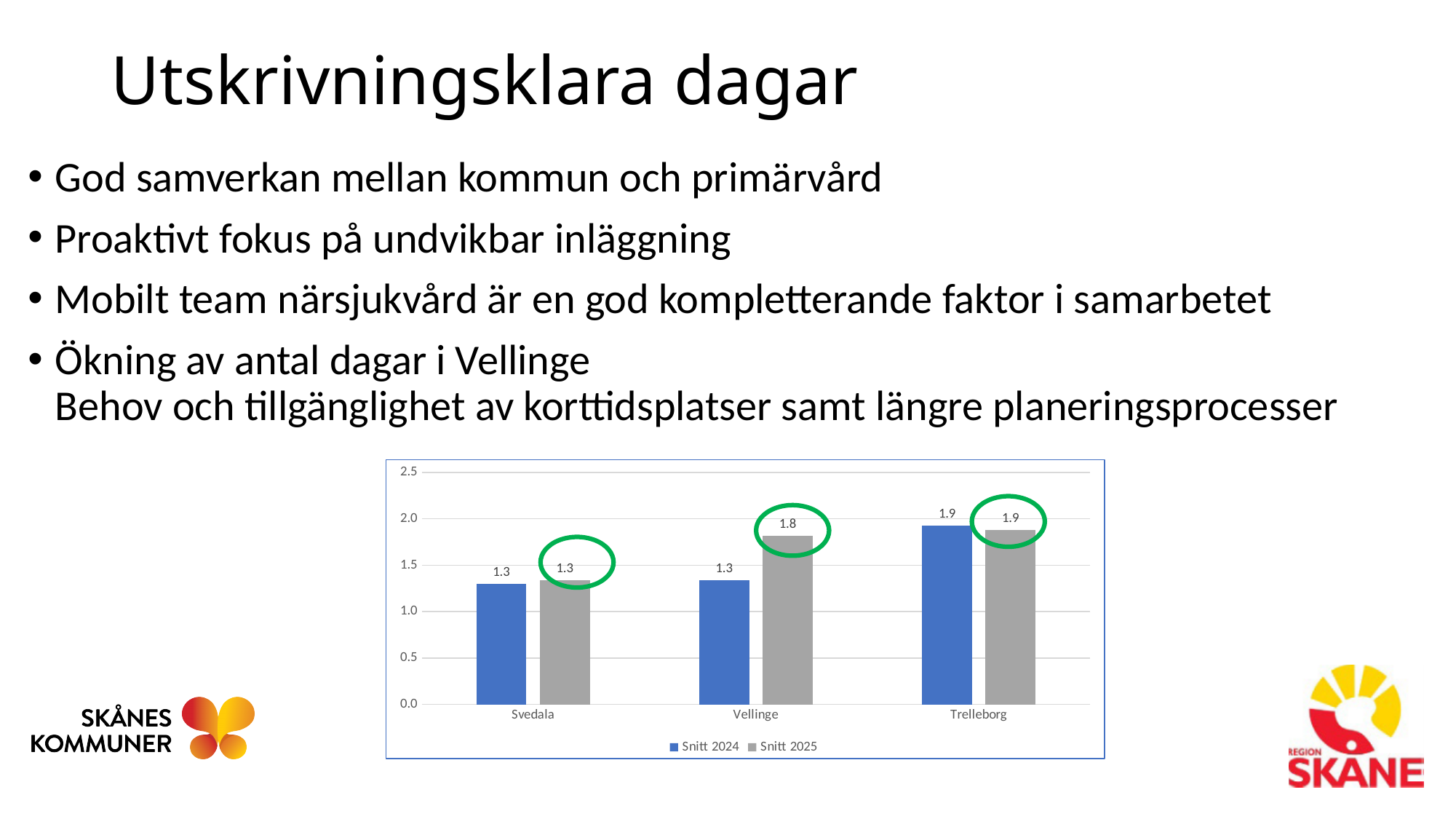
How many categories are shown on the x axis of the chart? 3 What is the value for Svedala in the Snitt 2025 series? 1.3 Which is larger for Vellinge: the Snitt 2024 value or the Snitt 2025 value? Snitt 2025 What kind of chart is shown on the slide? Bar chart What is the value for Trelleborg in the Snitt 2024 series? 1.9 Which category has the highest value in the Snitt 2025 series? Trelleborg Which category has the lowest value in the Snitt 2025 series? Svedala What is the difference between the Snitt 2025 and Snitt 2024 values for Vellinge? 0.5 What is the value for Vellinge in the Snitt 2025 series? 1.8 How many series does the chart legend list? 2 Is the Snitt 2024 value for Trelleborg greater or less than 1.5? greater Do the Snitt 2025 values rise or fall from Svedala to Trelleborg? Rise